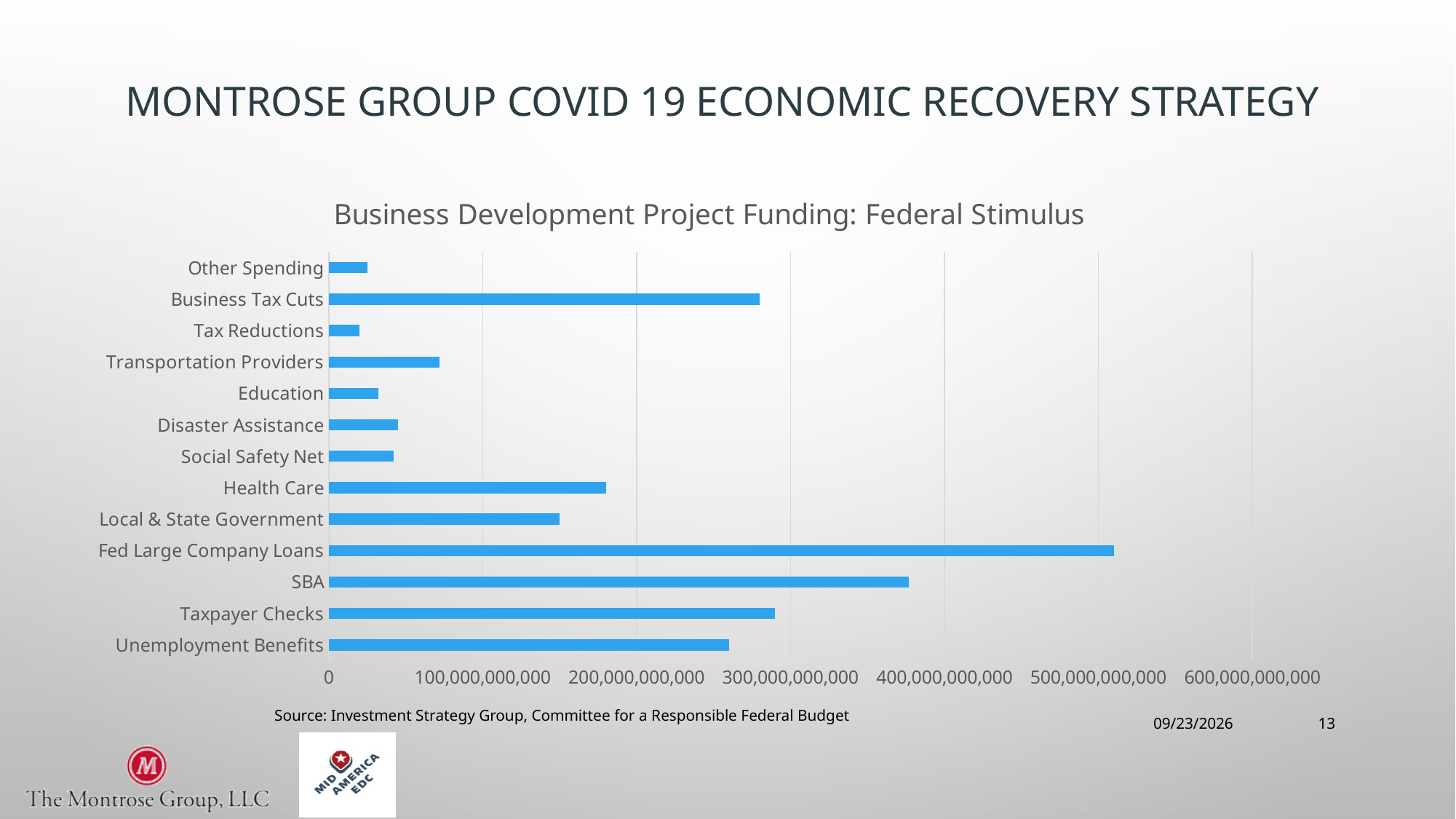
Is the value for SBA greater or less than 400,000,000,000? less Which category has the highest value? Fed Large Company Loans Which is larger, the value for SBA or the value for Business Tax Cuts? SBA Which is larger, the value for Health Care or the value for Local & State Government? Health Care Is the value for Business Tax Cuts greater or less than 300,000,000,000? less What type of chart is shown on the slide? Bar chart Is the value for Health Care greater or less than 200,000,000,000? less According to the slide, what is the source of the chart data? Investment Strategy Group, Committee for a Responsible Federal Budget What is the title of the chart? Business Development Project Funding: Federal Stimulus How many categories are plotted in the chart? 13